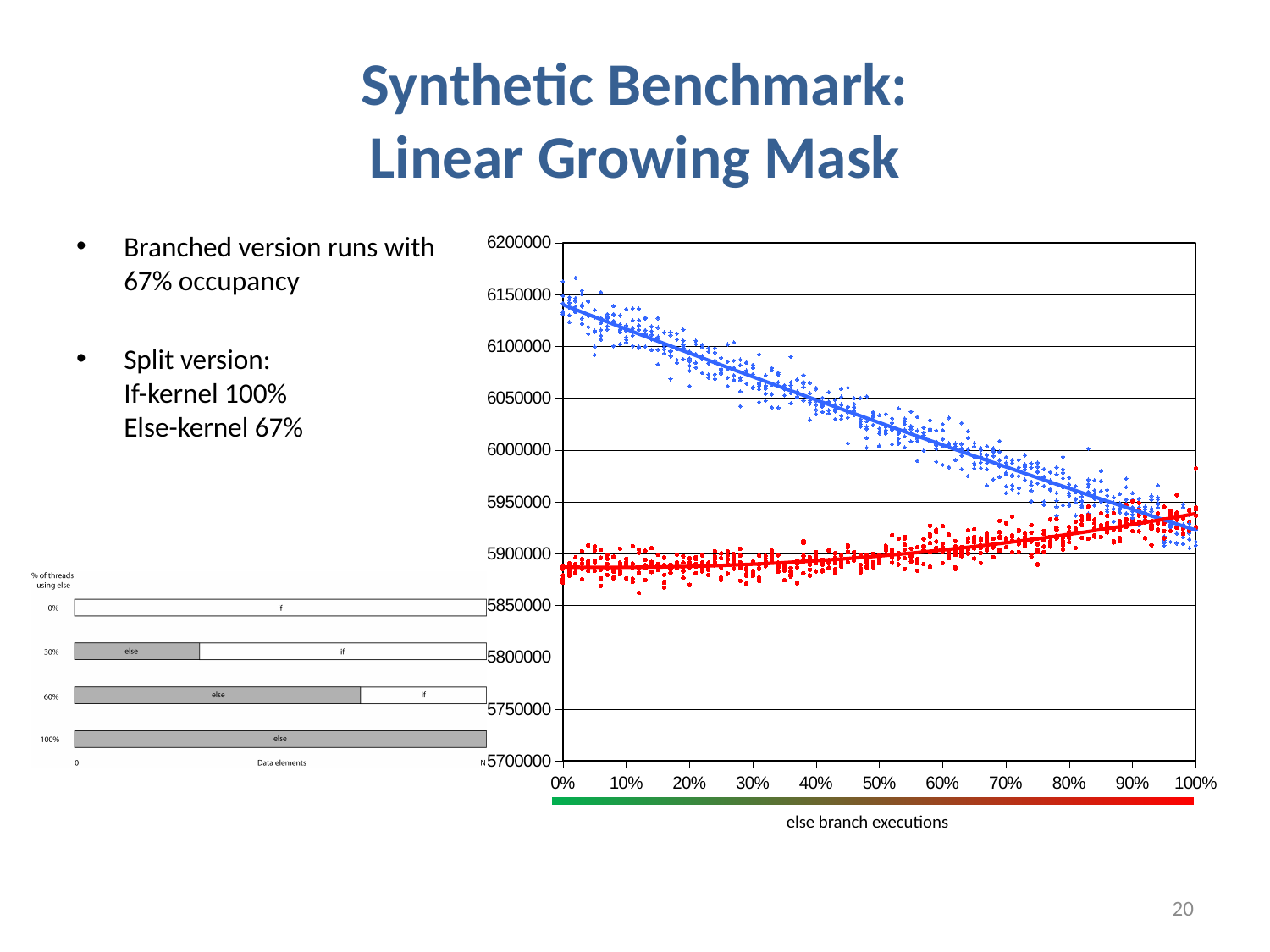
Does the red series rise or fall as the percentage of else branch executions increases from 0% to 100%? rise How many differently coloured series are plotted in the scatter chart? 2 Is the value of the red series at 100% greater or less than 5900000? greater Is the value of the blue series at 50% greater or less than 6000000? greater Is the value of the red series at 0% greater or less than 5900000? less At 20% else branch executions, which series has the larger value, the blue or the red? blue What is the highest value shown on the y axis of the scatter chart? 6200000 What is the label of the x axis of the scatter chart? else branch executions What kind of chart is shown on the right of the slide? scatter chart Does the blue series rise or fall as the percentage of else branch executions increases from 0% to 100%? fall